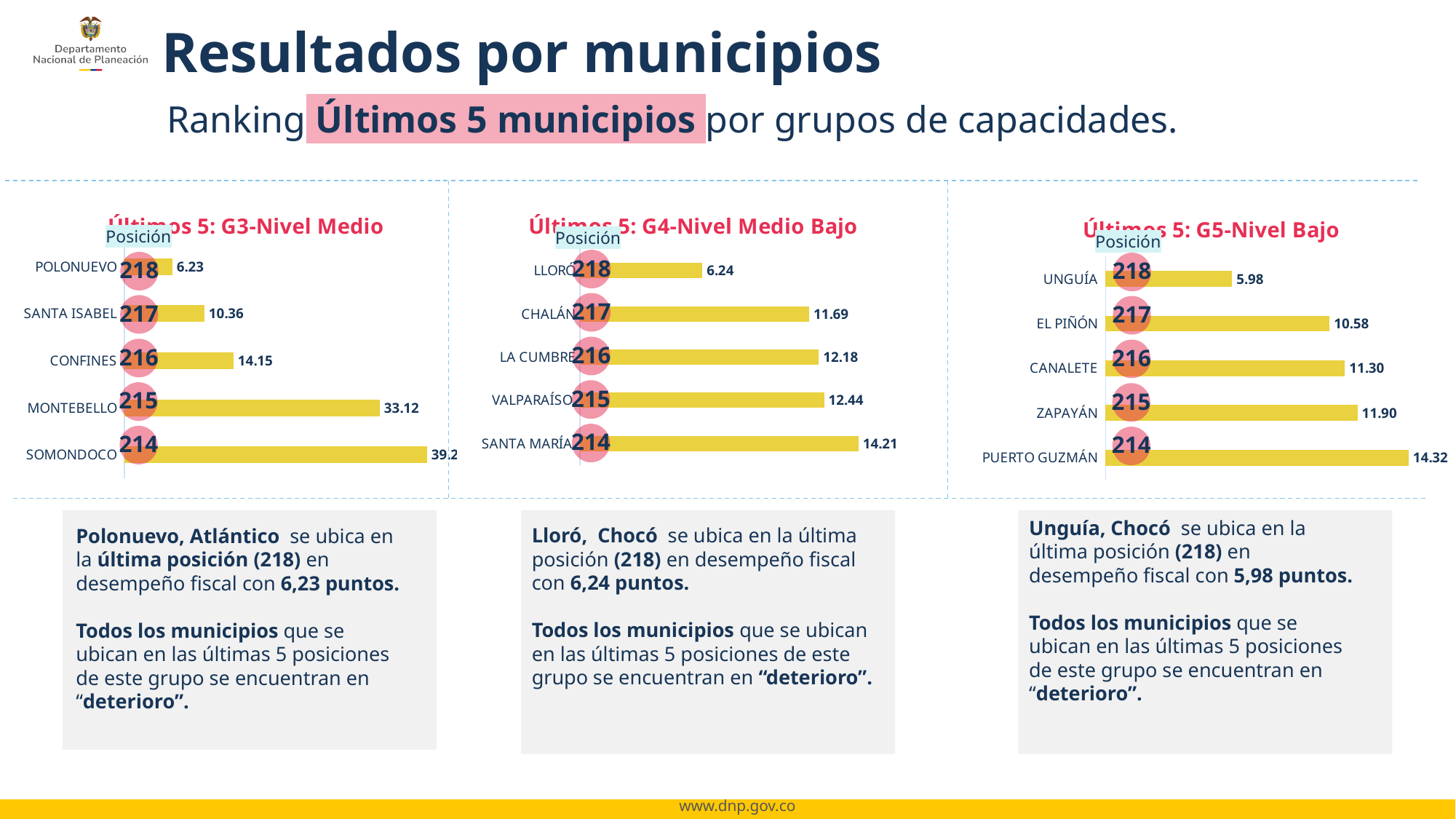
In the 'Últimos 5: G5-Nivel Bajo' chart, what is the difference between the values for PUERTO GUZMÁN and ZAPAYÁN? 2.42 In the 'Últimos 5: G3-Nivel Medio' chart, what is the value for MONTEBELLO? 33.12 In the 'Últimos 5: G3-Nivel Medio' chart, which municipality has the highest value? SOMONDOCO In the 'Últimos 5: G4-Nivel Medio Bajo' chart, what is the value for LA CUMBRE? 12.18 How many municipalities are shown in the 'Últimos 5: G5-Nivel Bajo' chart? 5 In the 'Últimos 5: G4-Nivel Medio Bajo' chart, which municipality has the highest value? SANTA MARÍA In the 'Últimos 5: G5-Nivel Bajo' chart, which municipality has the highest value? PUERTO GUZMÁN In the 'Últimos 5: G5-Nivel Bajo' chart, what is the value for UNGUÍA? 5.98 In the 'Últimos 5: G4-Nivel Medio Bajo' chart, which is larger, the value for CHALÁN or the value for LLORÓ? CHALÁN In the 'Últimos 5: G3-Nivel Medio' chart, what is the difference between the values for SANTA ISABEL and POLONUEVO? 4.13 What kind of chart is 'Últimos 5: G3-Nivel Medio'? Bar chart In the 'Últimos 5: G3-Nivel Medio' chart, which municipality has the lowest value? POLONUEVO